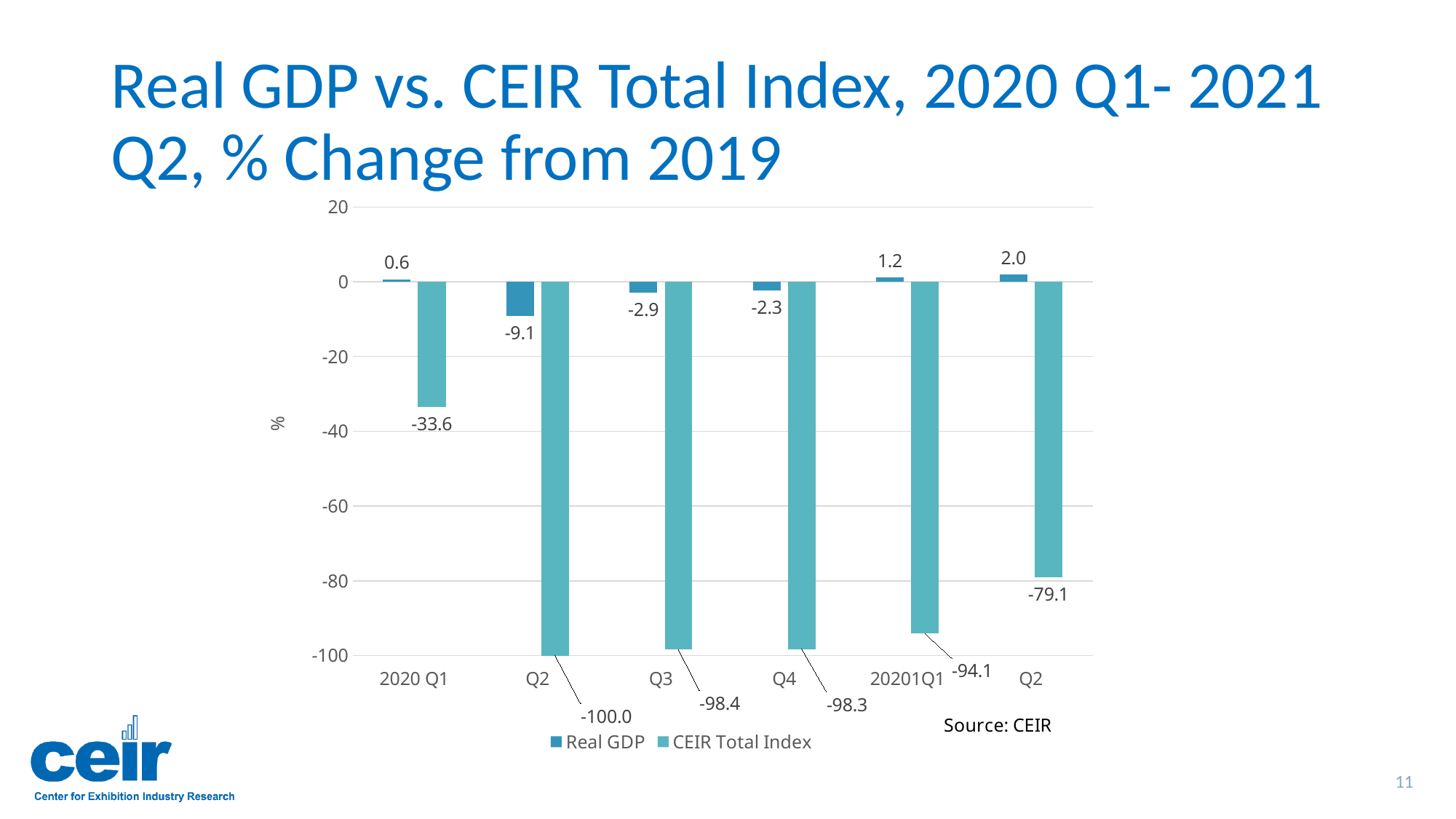
What is the Real GDP value for 2020 Q1? 0.6 Which category has the highest Real GDP value? Q2 (2021) What kind of chart is shown on the slide? Bar chart Which category has the lowest CEIR Total Index value? Q2 (2020) What is the Real GDP value for 2020 Q2? -9.1 What is the CEIR Total Index value for 2021 Q2 (the last category)? -79.1 Which category has the lowest Real GDP value? Q2 (2020) What is the difference between the CEIR Total Index values for 2020 Q1 and 2020 Q2? 66.4 What is the CEIR Total Index value for 2020 Q2? -100.0 How many series does the legend list? 2 What is the source cited for the chart? CEIR Which is larger, the Real GDP value for 2020 Q3 or for 2020 Q4? 2020 Q4